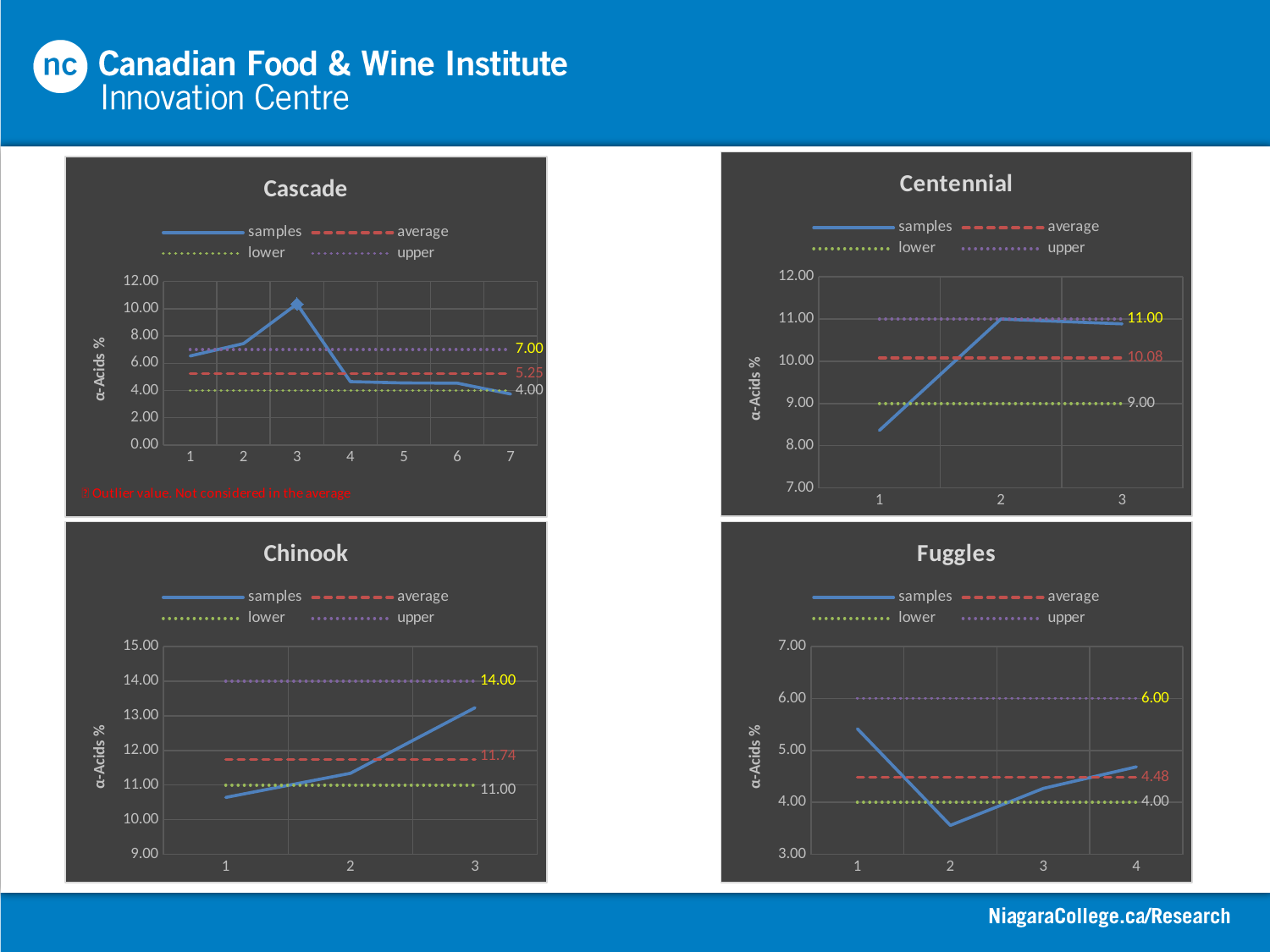
On the Chinook chart, what is the value of the upper line? 14.00 On the Fuggles chart, what is the value of the average line? 4.48 How many sample points are plotted on the Cascade chart? 7 On the Fuggles chart, what is the difference between the upper and lower lines? 2.00 On the Centennial chart, what is the value of the average line? 10.08 On the Cascade chart, what is the value of the average line? 5.25 How many sample points are plotted on the Fuggles chart? 4 On the Chinook chart, what is the difference between the upper and lower lines? 3.00 On the Chinook chart, is the samples value at point 3 greater or less than 13.00? greater What kind of chart is the Centennial chart? Line chart How many series does the legend of the Chinook chart list? 4 On the Cascade chart, which sample number has the highest samples value? 3